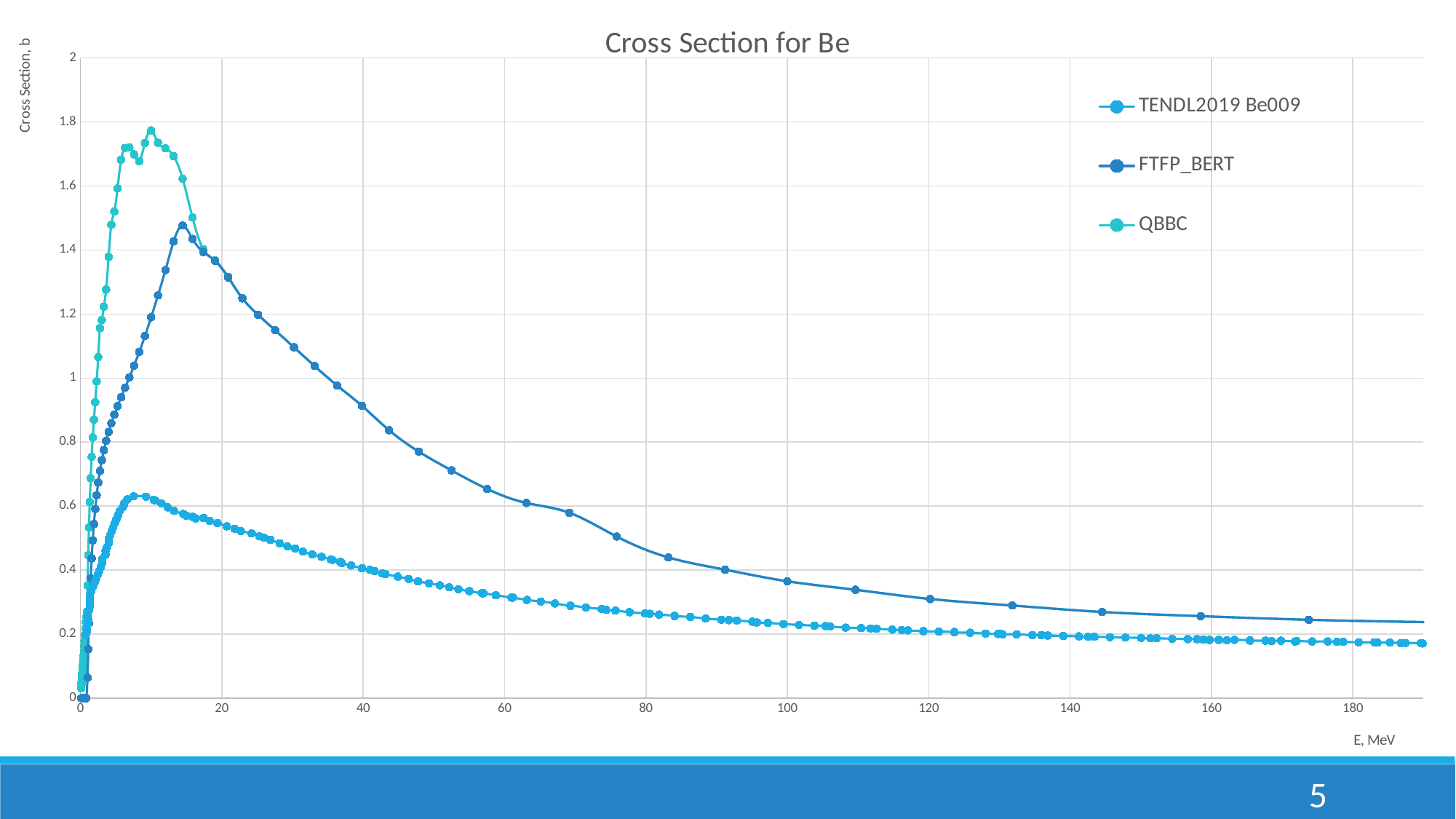
Which series reaches the highest peak value? QBBC How many series does the legend list? 3 What is the title of the chart? Cross Section for Be Does the FTFP_BERT series rise or fall as energy increases from 20 MeV to 180 MeV? Fall Is the peak value of the FTFP_BERT series greater or less than 1.6? less What is the label of the x axis? E, MeV Is the peak value of the QBBC series greater or less than 1.6? greater What kind of chart is shown on the slide? Line chart Is the FTFP_BERT value at 100 MeV greater or less than 0.4? less Which series has the lowest peak value? TENDL2019 Be009 At 40 MeV, which series has the larger value, FTFP_BERT or TENDL2019 Be009? FTFP_BERT